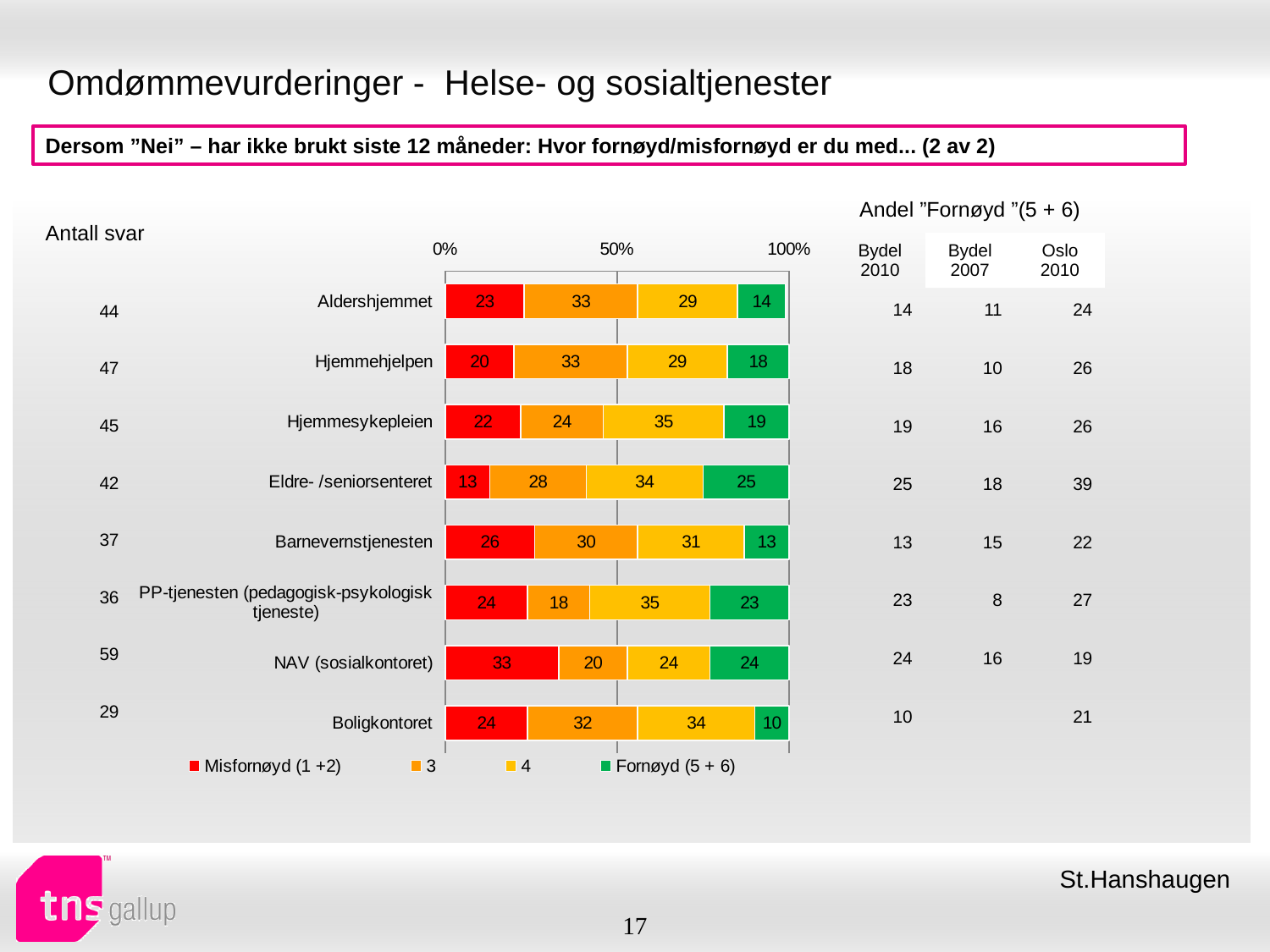
What is the difference between the Misfornøyd (1 +2) values for Aldershjemmet and Hjemmehjelpen? 3 Which has the larger '4' segment, Hjemmesykepleien or Barnevernstjenesten? Hjemmesykepleien Which category has the highest Misfornøyd (1 +2) value? NAV (sosialkontoret) What is the value of the Fornøyd (5 + 6) segment for Eldre- /seniorsenteret? 25 Which category has the lowest Fornøyd (5 + 6) value? Boligkontoret What is the value of the '3' segment for PP-tjenesten (pedagogisk-psykologisk tjeneste)? 18 What kind of chart is shown on the slide? Stacked bar chart What is the value of the Misfornøyd (1 +2) segment for NAV (sosialkontoret)? 33 What is the total of the stacked bar for Aldershjemmet? 99 What colour represents Fornøyd (5 + 6) in the chart? Green How many categories are shown in the chart? 8 How many series does the legend list? 4